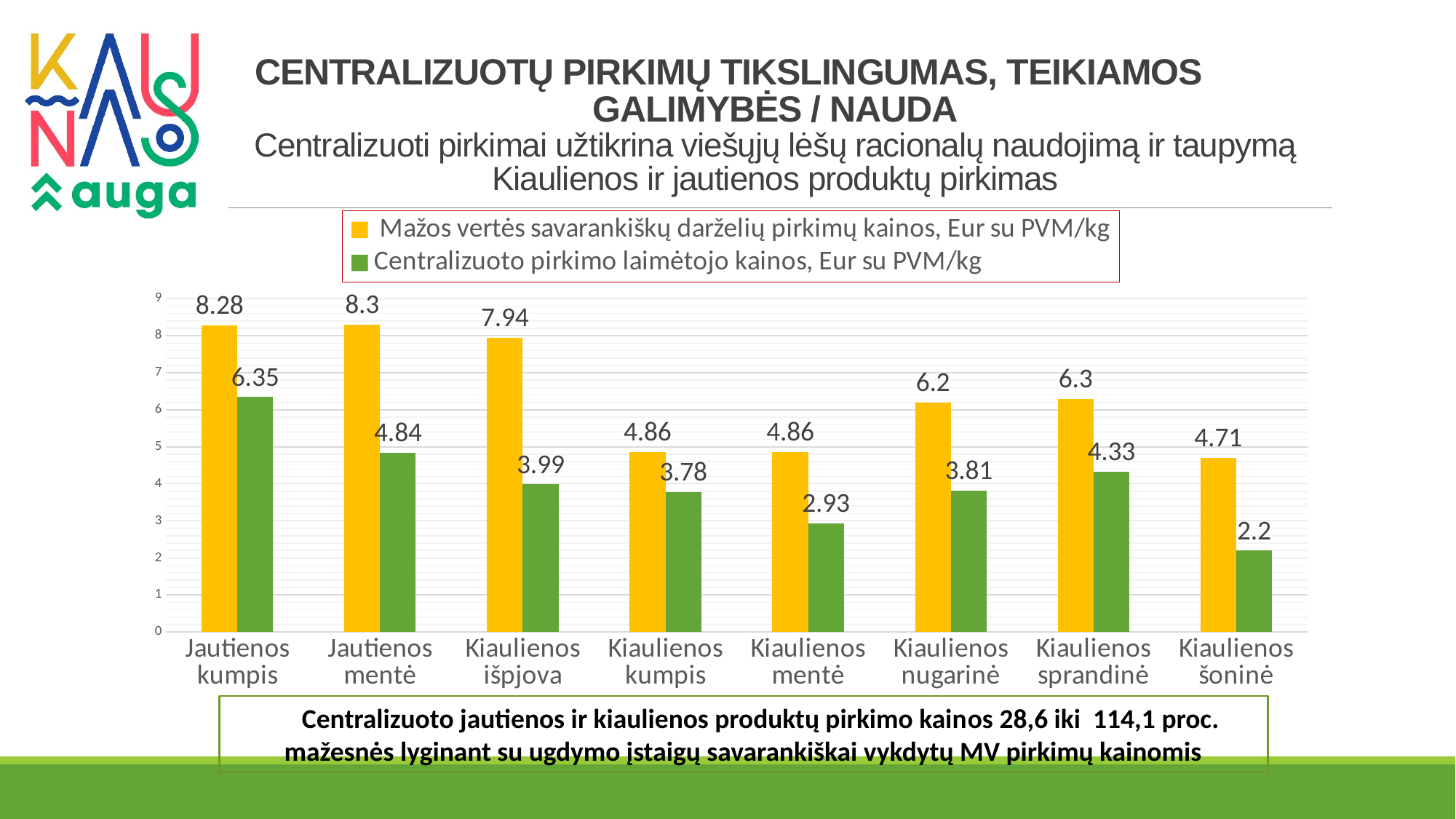
Which has a larger Centralizuoto pirkimo laimėtojo kainos value: Kiaulienos nugarinė or Kiaulienos sprandinė? Kiaulienos sprandinė Which category has the lowest Centralizuoto pirkimo laimėtojo kainos value? Kiaulienos šoninė What is the Centralizuoto pirkimo laimėtojo kainos value for Kiaulienos sprandinė? 4.33 What is the value of Mažos vertės savarankiškų darželių pirkimų kainos for Jautienos kumpis? 8.28 Which category has the highest Centralizuoto pirkimo laimėtojo kainos value? Jautienos kumpis What kind of chart is shown on the slide? bar chart What is the difference between the two series values for Kiaulienos šoninė? 2.51 Is the Mažos vertės savarankiškų darželių pirkimų kainos value for Kiaulienos išpjova greater or less than 7? greater What is the Centralizuoto pirkimo laimėtojo kainos value for Kiaulienos mentė? 2.93 What is the difference between the two series values for Jautienos kumpis? 1.93 How many series does the legend list? 2 How many product categories are shown on the x axis? 8